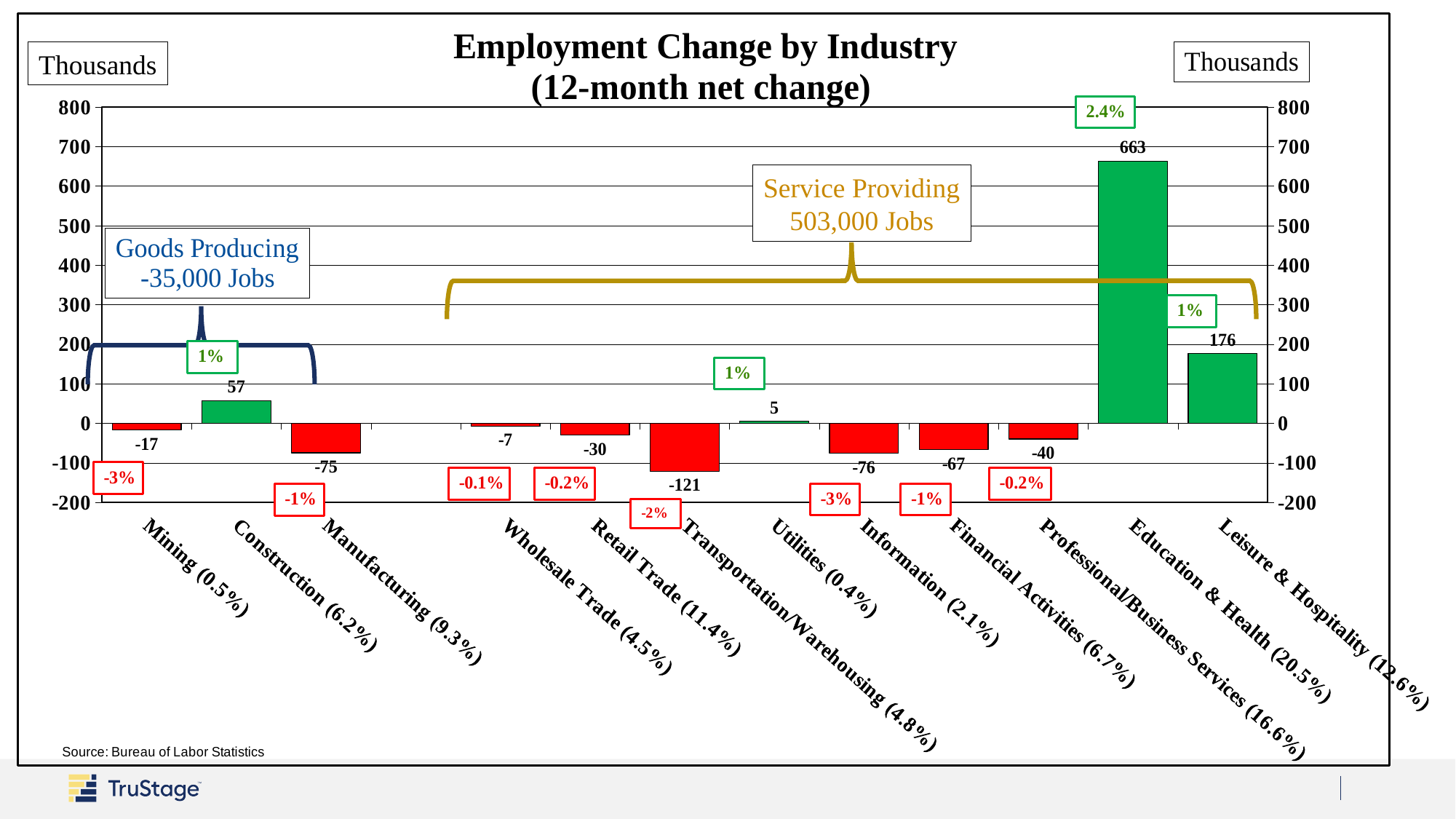
What kind of chart is shown on the slide? Bar chart What is the 12-month net employment change for Transportation/Warehousing? -121 What is the 12-month net employment change for Utilities? 5 What is the difference between the net employment change for Education & Health and for Leisure & Hospitality? 487 What is the 12-month net employment change for Construction? 57 How many industries are shown on the chart? 12 Which industry has the lowest 12-month net employment change? Transportation/Warehousing According to the annotation on the chart, how many jobs did the Service Providing sector add? 503,000 Jobs What is the 12-month net employment change for Education & Health? 663 Which has a larger net employment change, Construction or Leisure & Hospitality? Leisure & Hospitality Which industry has the highest 12-month net employment change? Education & Health What unit is shown on the vertical axis of the chart? Thousands